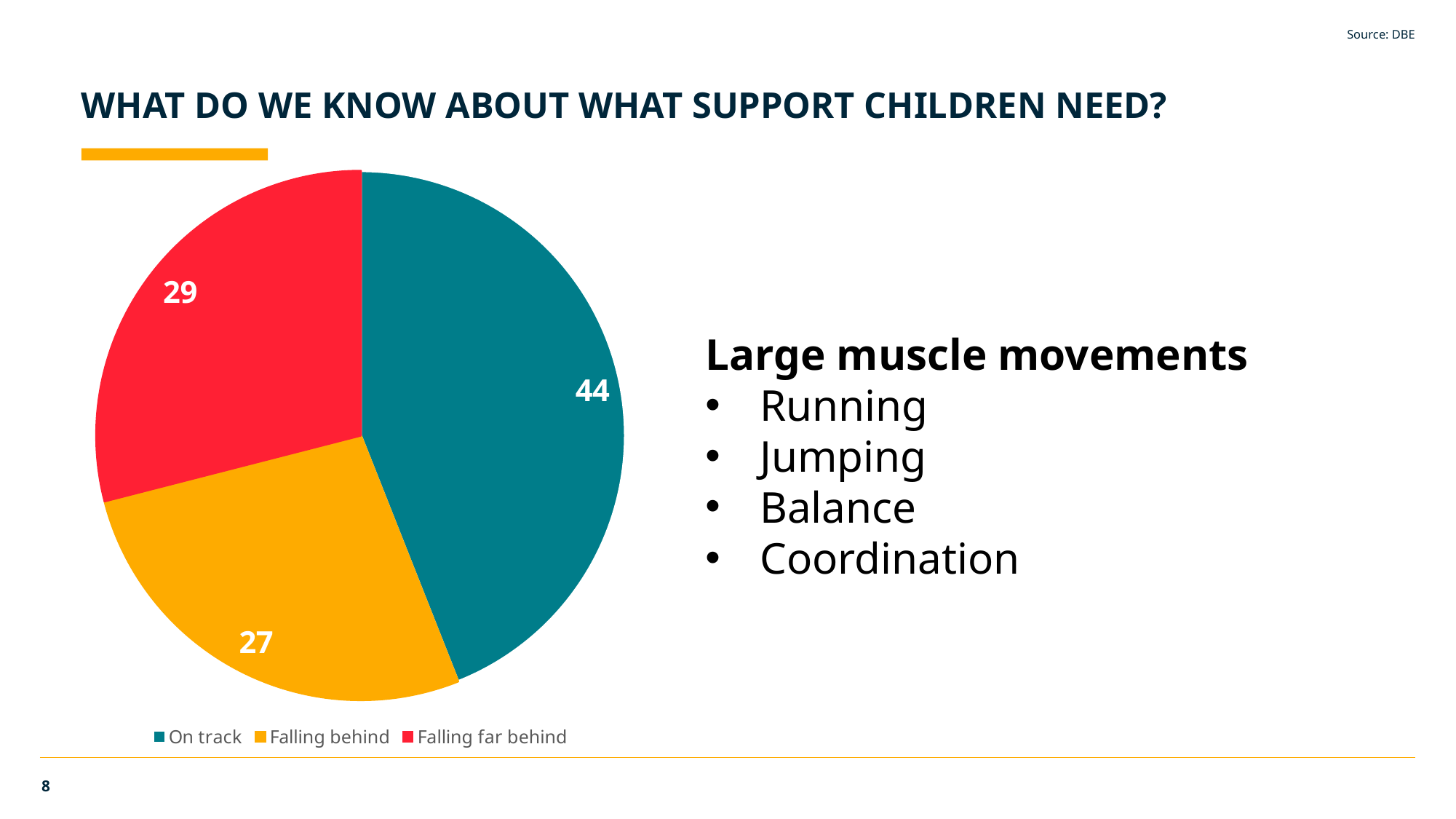
What is the value for Falling far behind in the pie chart? 29 Which is larger, the value for On track or the value for Falling far behind? On track What kind of chart is shown on the slide? Pie chart What is the total of all the slice values in the pie chart? 100 Which category has the smallest slice in the pie chart? Falling behind What colour is the Falling far behind slice in the pie chart? Red Which category has the largest slice in the pie chart? On track What is the value for On track in the pie chart? 44 How many slices does the pie chart have? 3 What is the difference between the On track value and the Falling behind value? 17 What is the difference between the Falling far behind value and the Falling behind value? 2 What is the value for Falling behind in the pie chart? 27